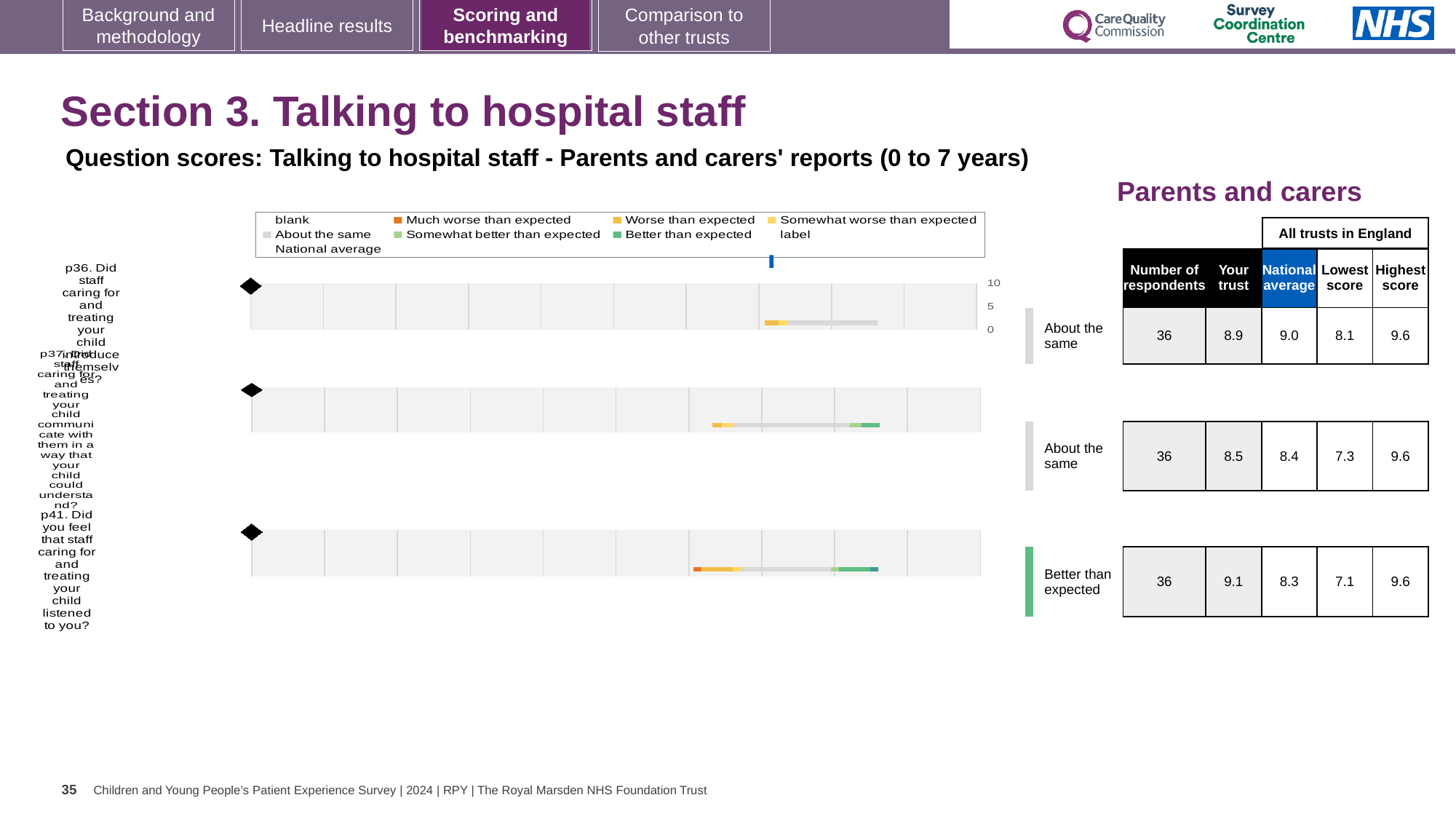
What kind of chart is used to show the question scores on this slide? bar chart What colour does the legend use for 'Better than expected'? green Which of the three questions has the highest 'Your trust' score? p41 What is the national average score for p37 (Did staff communicate with your child in a way they could understand)? 8.4 What is the highest value shown on the chart's axis? 10 For p41, is the 'Your trust' score or the national average higher? Your trust What is the difference between the 'Your trust' score and the national average for p41? 0.8 What is the 'Your trust' score for p41 (Did you feel that staff listened to you)? 9.1 How many respondents answered p36? 36 How many questions (bars) are plotted in the chart? 3 What is the lowest score among all trusts in England for p41? 7.1 What is the 'Your trust' score for p36 (Did staff caring for and treating your child introduce themselves)? 8.9